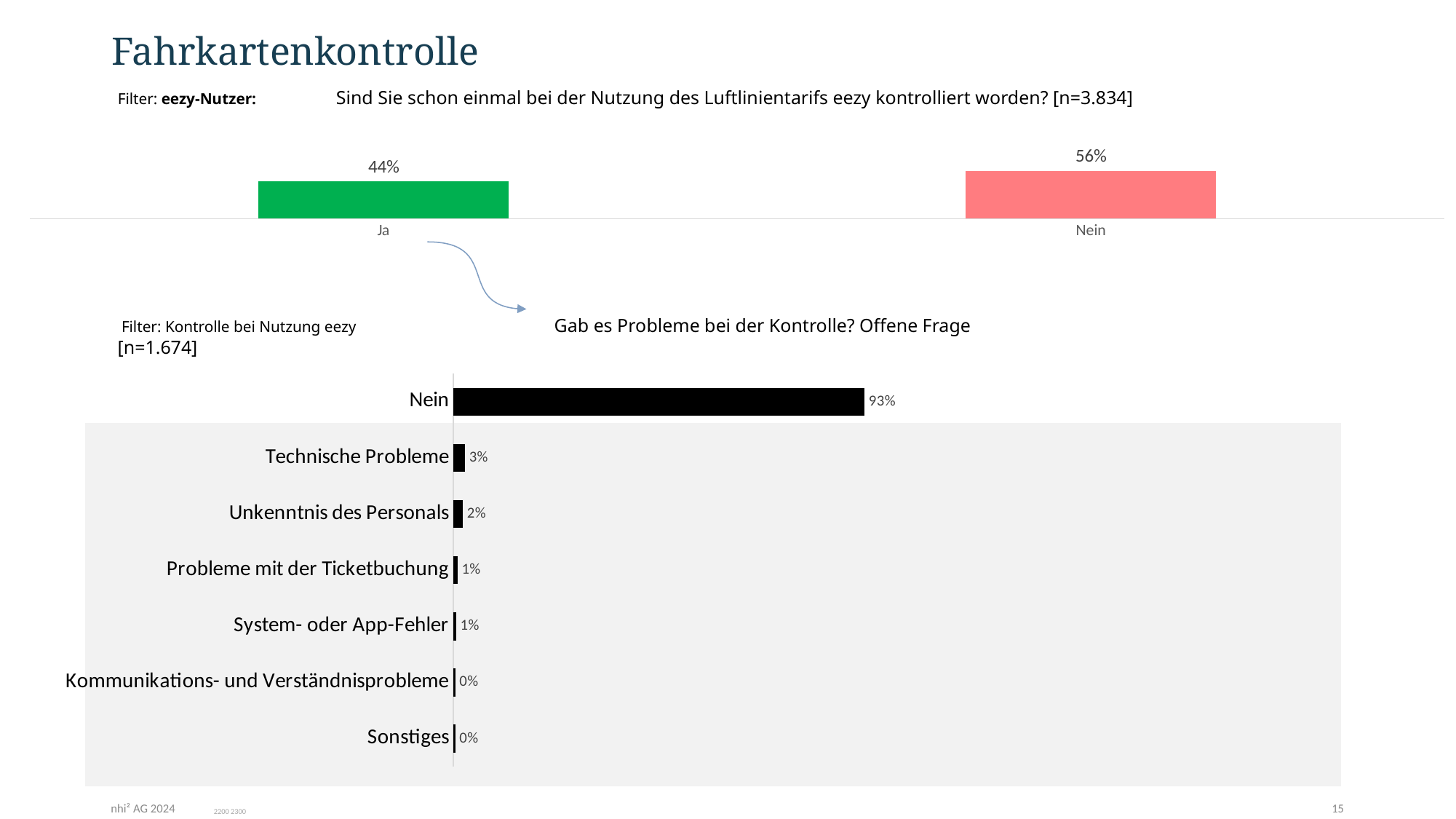
In the top chart (Sind Sie schon einmal bei der Nutzung des Luftlinientarifs eezy kontrolliert worden?), what is the value for Ja? 44% In the top chart (Sind Sie schon einmal bei der Nutzung des Luftlinientarifs eezy kontrolliert worden?), what is the value for Nein? 56% In the bottom chart (Gab es Probleme bei der Kontrolle?), what is the value for Probleme mit der Ticketbuchung? 1% In the bottom chart (Gab es Probleme bei der Kontrolle?), what is the difference between the values for Technische Probleme and Unkenntnis des Personals? 1% In the top chart, which category has the higher value, Ja or Nein? Nein In the bottom chart (Gab es Probleme bei der Kontrolle?), how many categories are shown? 7 In the bottom chart (Gab es Probleme bei der Kontrolle?), which category has the highest value? Nein What kind of chart is the bottom chart (Gab es Probleme bei der Kontrolle?)? Bar chart In the bottom chart (Gab es Probleme bei der Kontrolle?), what is the value for Nein? 93% In the bottom chart (Gab es Probleme bei der Kontrolle?), what is the value for Unkenntnis des Personals? 2% In the bottom chart (Gab es Probleme bei der Kontrolle?), what is the value for Technische Probleme? 3% In the top chart, what is the difference between the values for Nein and Ja? 12%